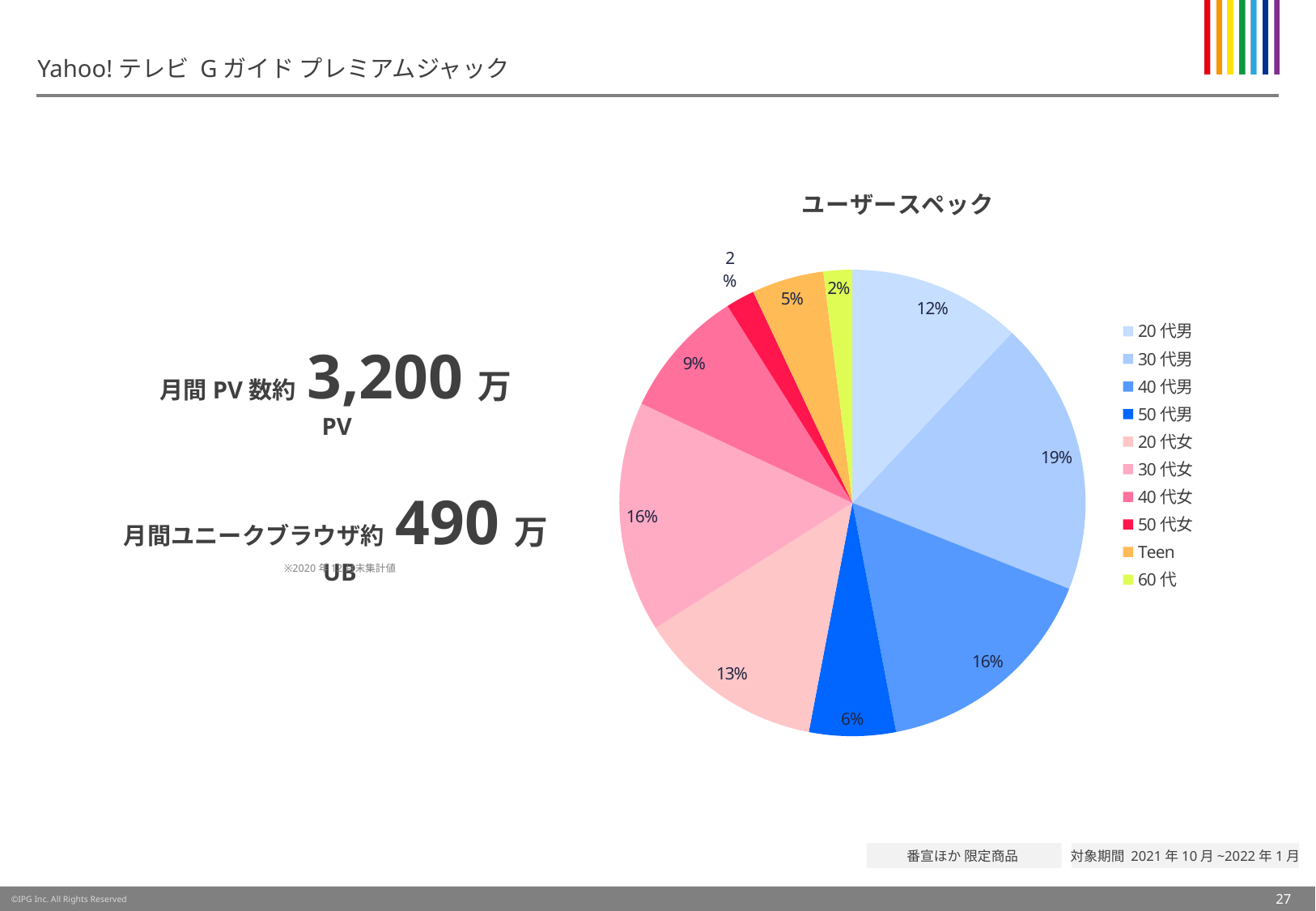
What share of the pie does 20代男 hold? 12% Which category has the largest share of the pie? 30代男 How many categories does the legend of the pie chart list? 10 What is the title of the chart? ユーザースペック What share of the pie does 40代女 hold? 9% Which is larger, the share for 20代女 or the share for 40代女? 20代女 What is the difference between the share for 30代男 and the share for 50代男? 13% What share of the pie does Teen hold? 5% What share of the pie does 30代男 hold? 19% What type of chart is shown on the slide? pie chart What is the combined share of 40代男 and 30代女? 32% What share of the pie does 50代男 hold? 6%